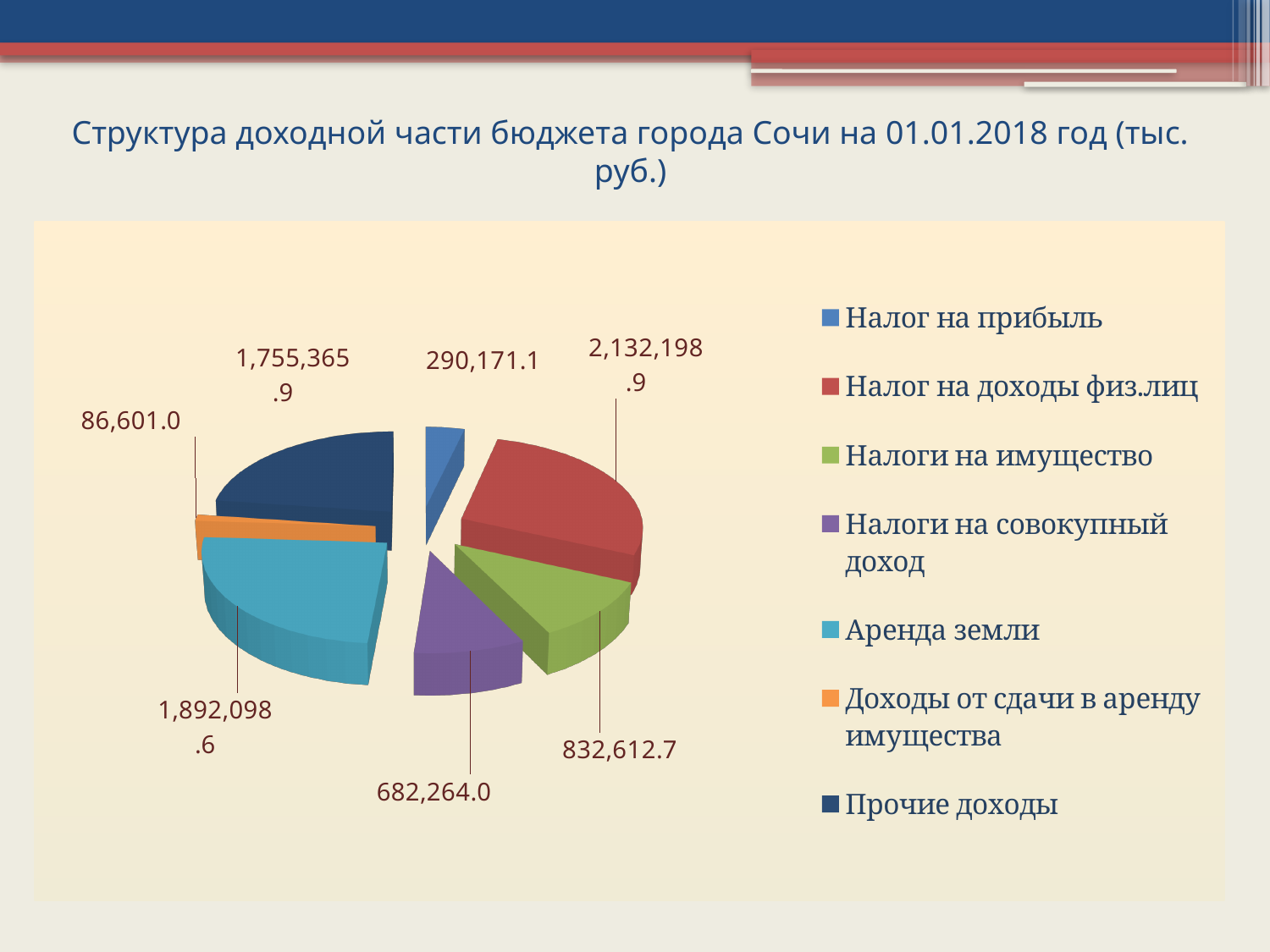
What colour is the slice for Налоги на имущество? Green What is the value for Аренда земли? 1,892,098.6 Which is larger, Аренда земли or Прочие доходы? Аренда земли What is the difference between Налог на доходы физ.лиц and Аренда земли? 240,100.3 What is the value for Доходы от сдачи в аренду имущества? 86,601.0 How many categories does the pie chart have? 7 What is the value for Налоги на совокупный доход? 682,264.0 What type of chart is shown on the slide? Pie chart Which category has the smallest value? Доходы от сдачи в аренду имущества What is the value for Налог на доходы физ.лиц? 2,132,198.9 Which category has the largest value? Налог на доходы физ.лиц What is the difference between Налоги на имущество and Налоги на совокупный доход? 150,348.7